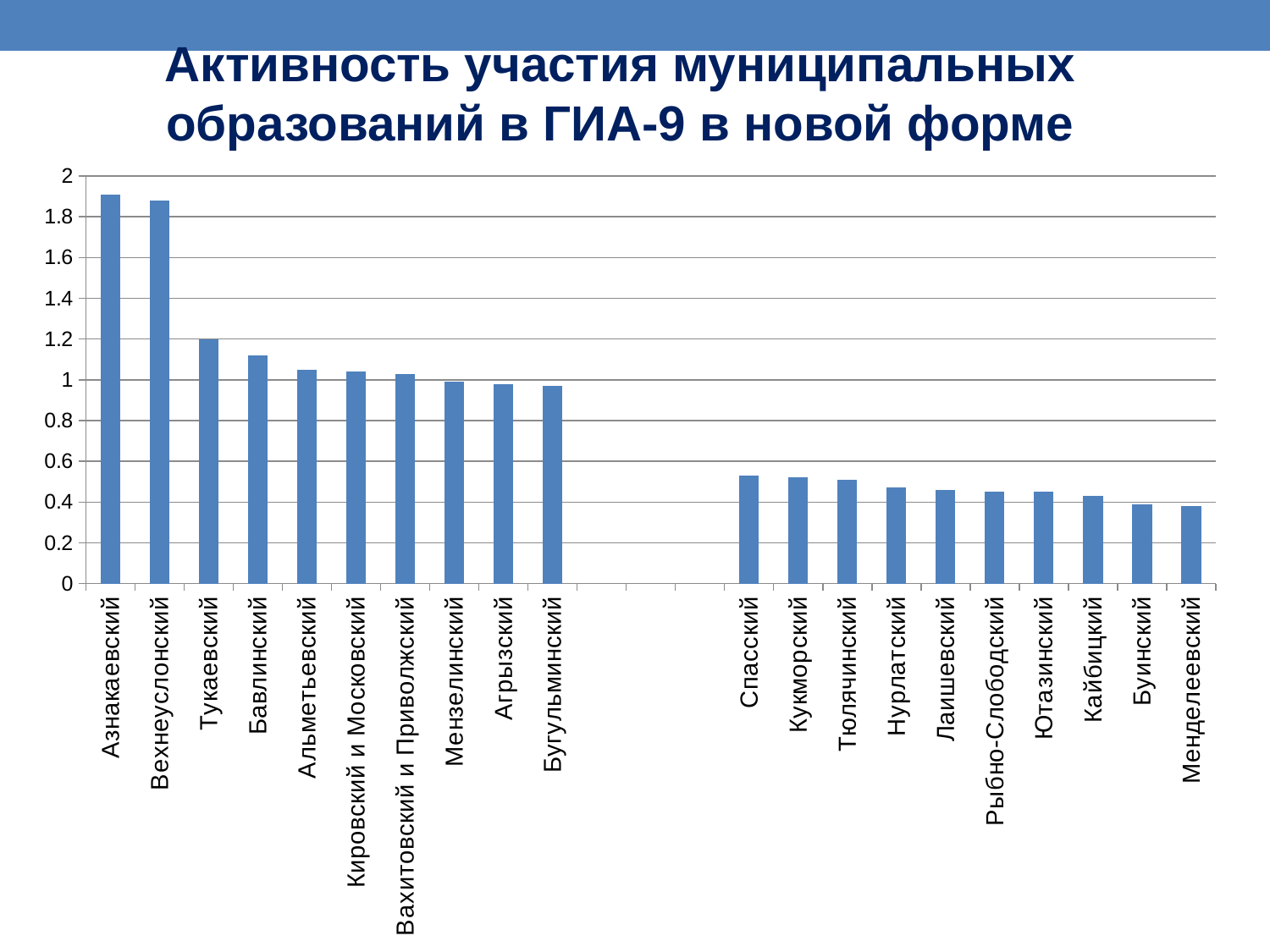
Is the value for Азнакаевский greater or less than 1.8? greater Is the value for Кукморский greater or less than 0.6? less Which has the larger value, Азнакаевский or Спасский? Азнакаевский Which has the larger value, Тукаевский or Бавлинский? Тукаевский How many labelled bars are plotted in the chart? 20 Is the value for Бавлинский greater or less than 1? greater What is the title of the chart? Активность участия муниципальных образований в ГИА-9 в новой форме What kind of chart is shown on the slide? bar chart Do the values generally rise or fall moving from left to right along the x axis? fall